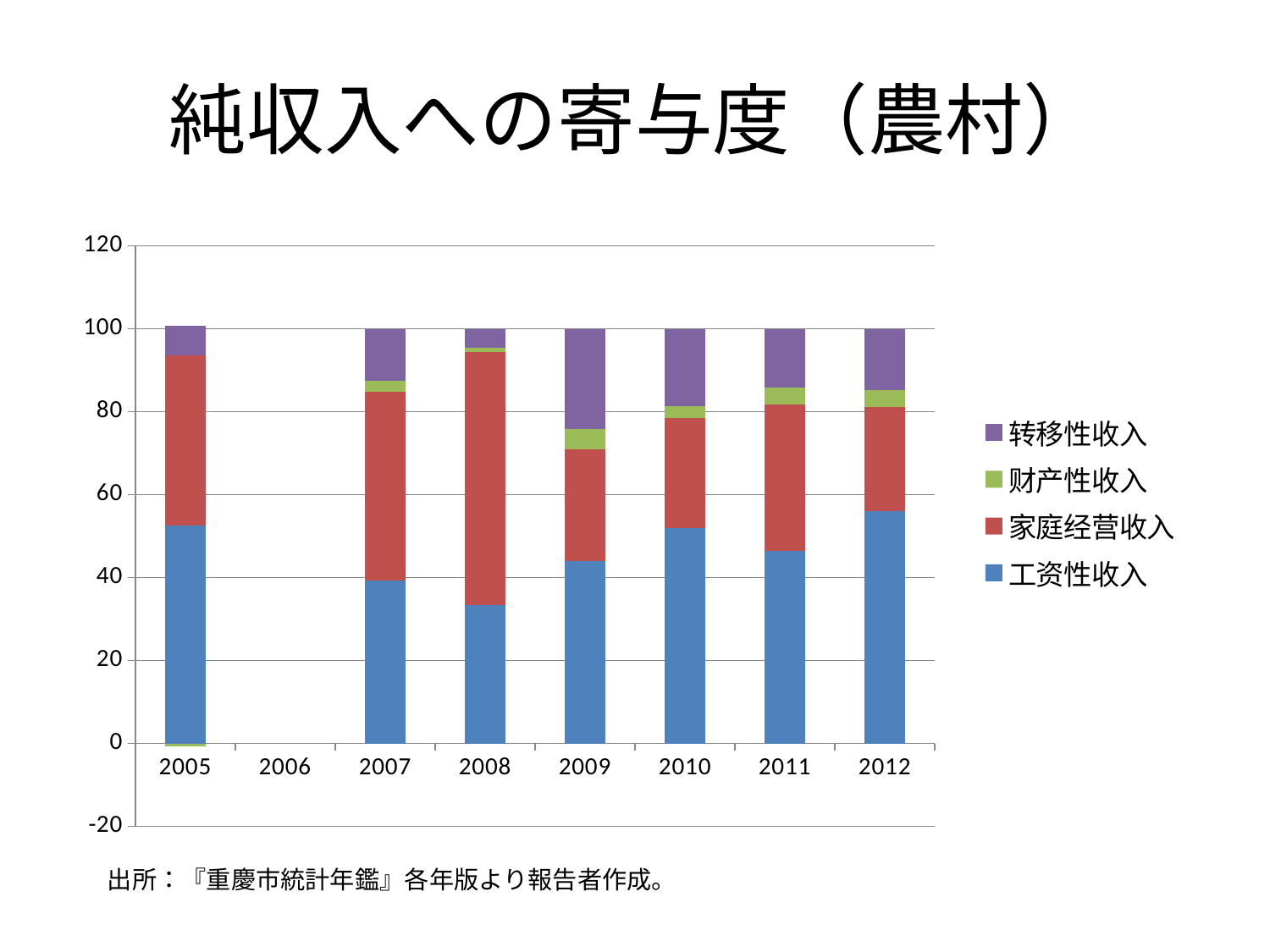
What kind of chart is shown on the slide? Stacked bar chart Is the value for 工资性收入 in 2005 greater or less than 40? greater Is the value for 工资性收入 in 2012 greater or less than 40? greater Is the value for 工资性收入 in 2008 greater or less than 40? less In which year is the 工资性收入 segment the largest? 2012 Which year on the x axis has no bar plotted? 2006 In which year is the 工资性收入 segment the smallest? 2008 Which year has the larger 转移性收入 segment, 2008 or 2009? 2009 How many series does the legend list? 4 What is the title of the chart? 純収入への寄与度（農村） Which year has the larger 工资性收入 segment, 2008 or 2012? 2012 How many years are labeled on the x axis? 8